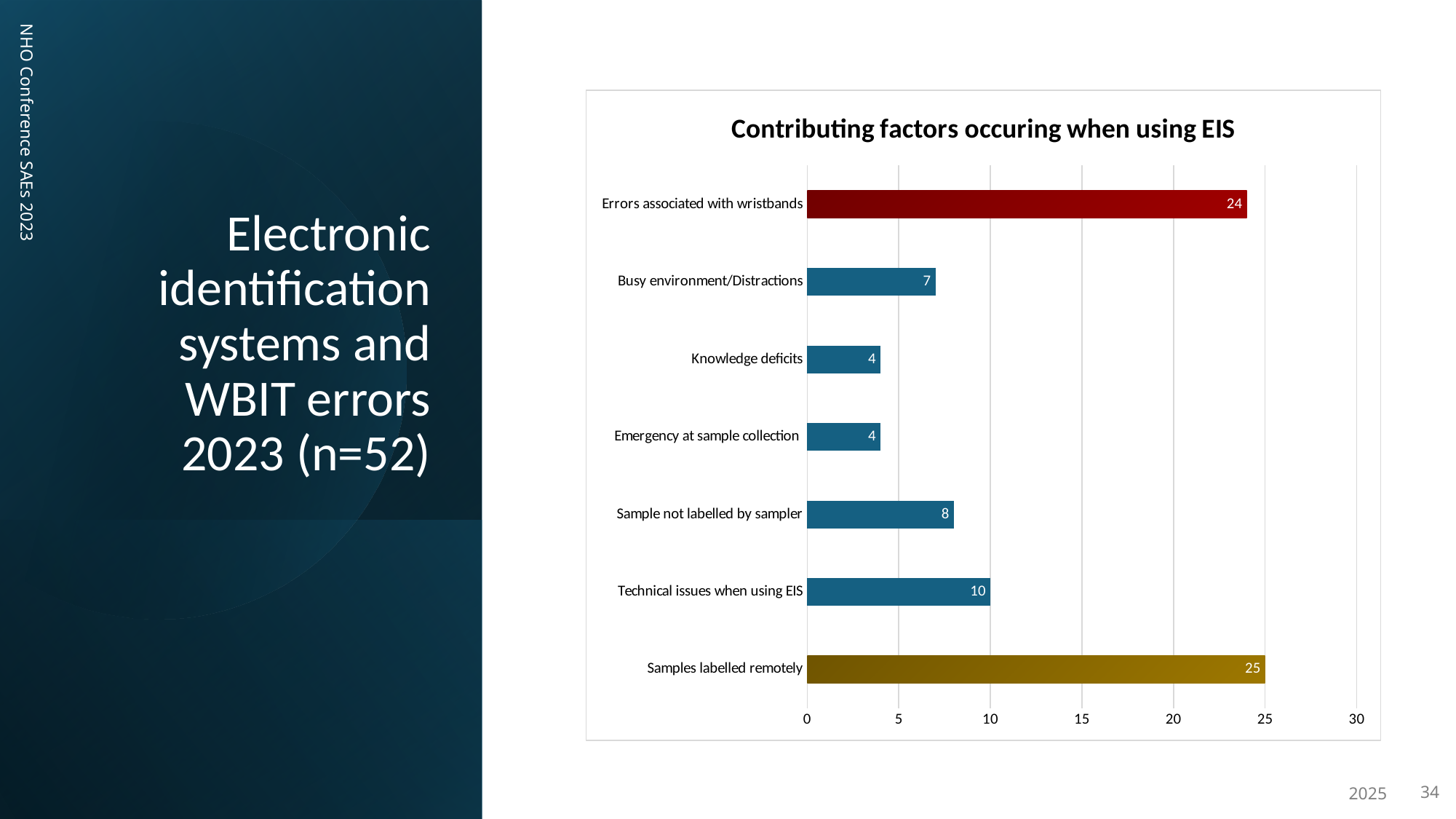
What is the value for Knowledge deficits? 4 What is the title of the chart? Contributing factors occuring when using EIS What is the difference between Samples labelled remotely and Errors associated with wristbands? 1 Which category has the highest value? Samples labelled remotely How many categories are shown in the chart? 7 What is the value for Technical issues when using EIS? 10 Which is larger, Busy environment/Distractions or Sample not labelled by sampler? Sample not labelled by sampler What is the value for Errors associated with wristbands? 24 Is the value for Technical issues when using EIS greater or less than 5? greater What kind of chart is shown on the slide? Bar chart What is the difference between Technical issues when using EIS and Sample not labelled by sampler? 2 What is the value for Busy environment/Distractions? 7